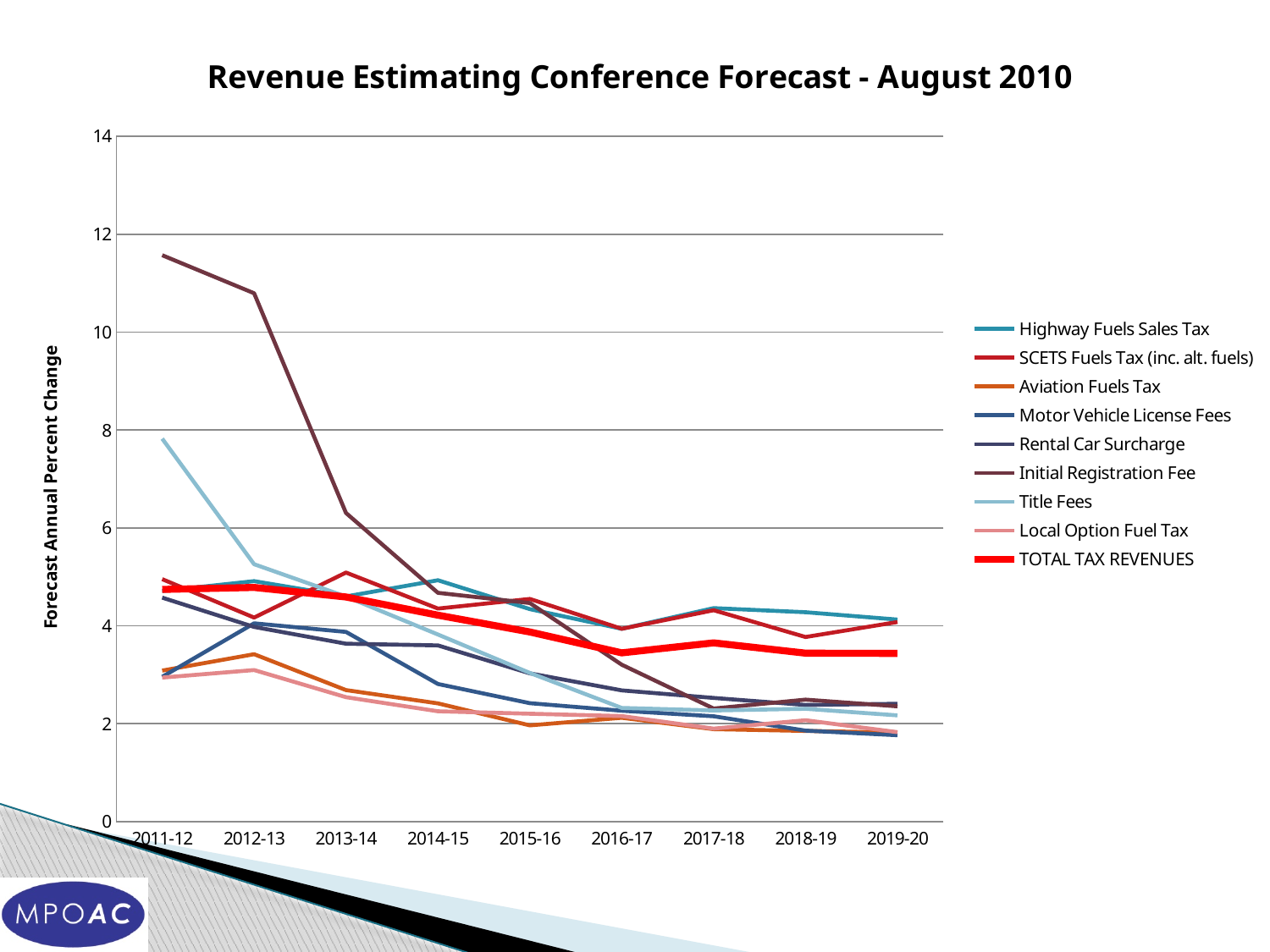
What is the title of the y axis? Forecast Annual Percent Change Is the value for Initial Registration Fee in 2011-12 greater or less than 10? greater How many fiscal years are shown along the x axis? 9 How many series does the legend list? 9 Does the Initial Registration Fee line rise or fall from 2011-12 to 2019-20? fall Which series has the highest value in 2011-12? Initial Registration Fee In 2011-12, which is larger: Title Fees or Aviation Fuels Tax? Title Fees Is the value for TOTAL TAX REVENUES in 2019-20 greater or less than 4? less In 2014-15, which is larger: Highway Fuels Sales Tax or Motor Vehicle License Fees? Highway Fuels Sales Tax Is the value for Title Fees in 2011-12 greater or less than 6? greater What kind of chart is shown on the slide? line chart